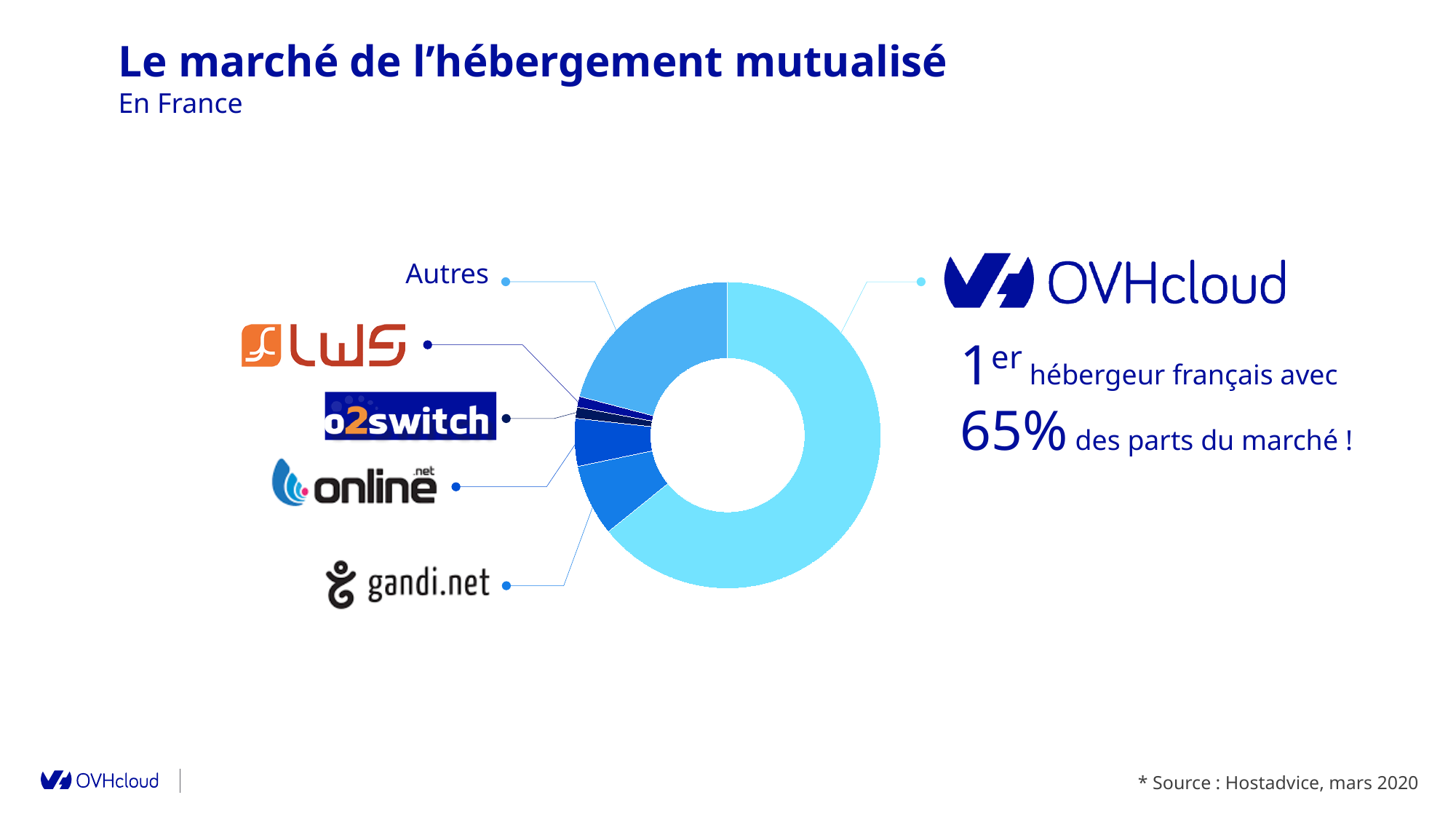
Which slice is larger, Autres or online.net? Autres What source is cited for the chart data? Hostadvice, mars 2020 Which slice is larger, online.net or o2switch? online.net Which slice is larger, gandi.net or LWS? gandi.net How many hosting providers or categories are shown as slices in the chart? 6 Which provider has the largest share of the shared hosting market in the chart? OVHcloud What kind of chart is shown on the slide? pie chart (doughnut) What is the title of the slide containing the chart? Le marché de l'hébergement mutualisé What market share does OVHcloud hold according to the slide? 65%